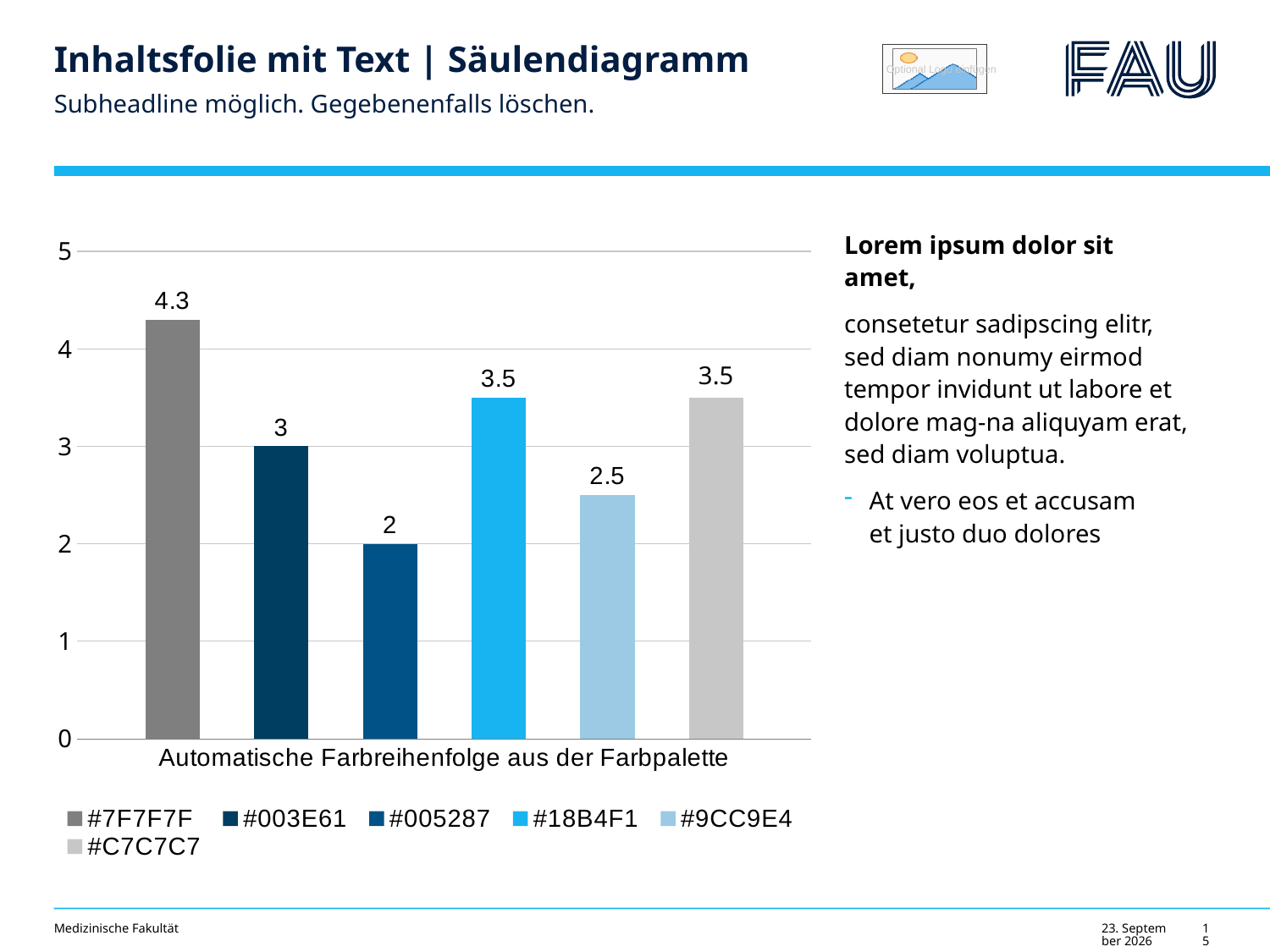
What is the value of the #003E61 series? 3 How many series does the legend list? 6 What kind of chart is shown on the slide? bar chart What is the value of the #005287 series? 2 What is the difference between the values of #7F7F7F and #003E61? 1.3 What is the value of the #7F7F7F series? 4.3 Which series has the highest value? #7F7F7F What is the highest value shown on the y axis? 5 What is the category label shown on the x axis? Automatische Farbreihenfolge aus der Farbpalette Which is larger, the value for #18B4F1 or the value for #9CC9E4? #18B4F1 Which series has the lowest value? #005287 What is the value of the #9CC9E4 series? 2.5